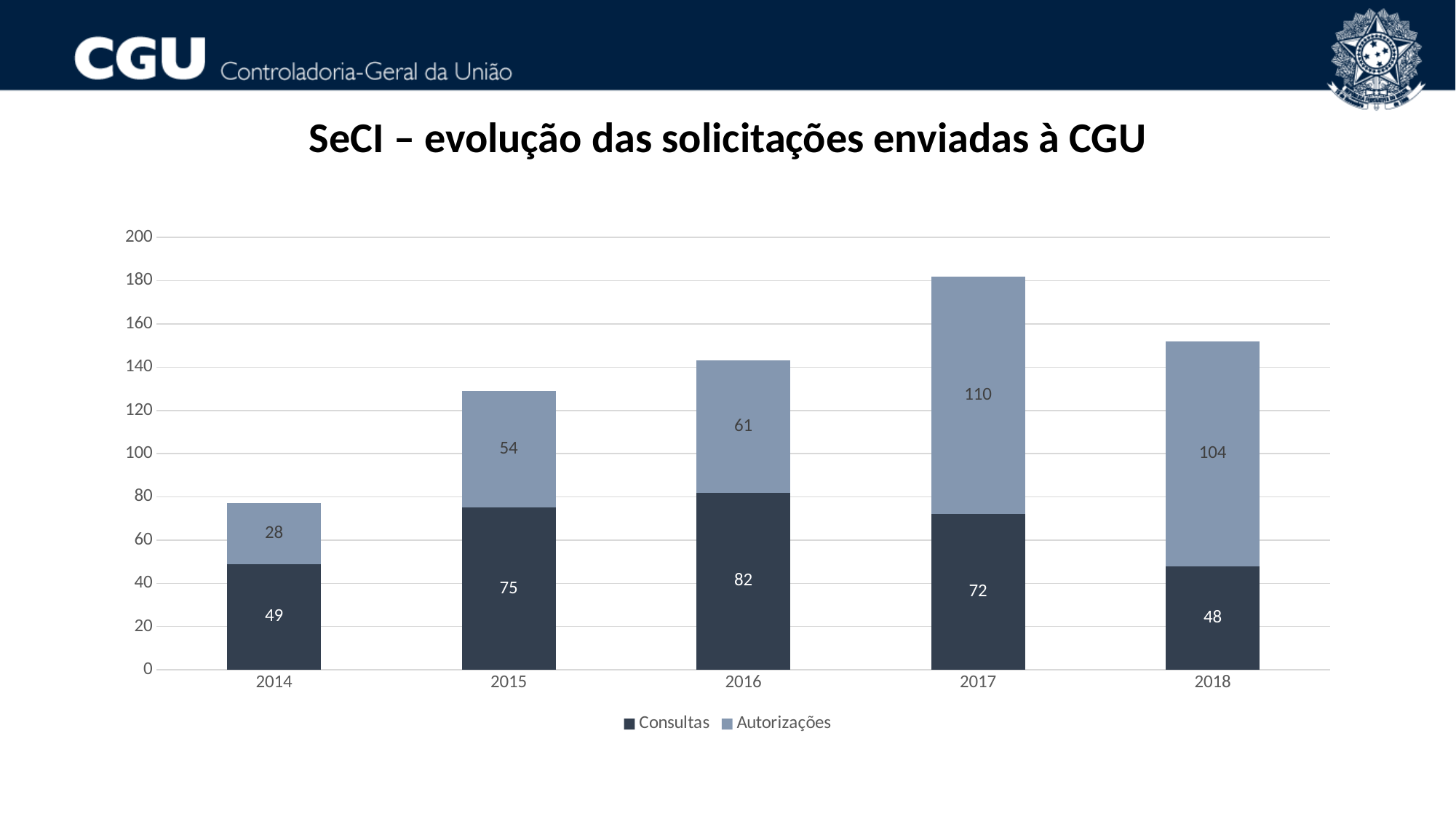
What is the total of the stacked bar for 2014? 77 What is the value of Consultas for 2016? 82 What is the value of Consultas for 2014? 49 How many series does the legend list? 2 What kind of chart is shown on the slide? Stacked bar chart How many years are shown on the x axis? 5 Which year has the highest value for Autorizações? 2017 What is the total of the stacked bar for 2017? 182 What is the value of Autorizações for 2018? 104 Which is larger: Consultas in 2015 or Consultas in 2017? Consultas in 2015 Which year has the lowest value for Consultas? 2018 What is the difference between Autorizações in 2017 and Autorizações in 2016? 49